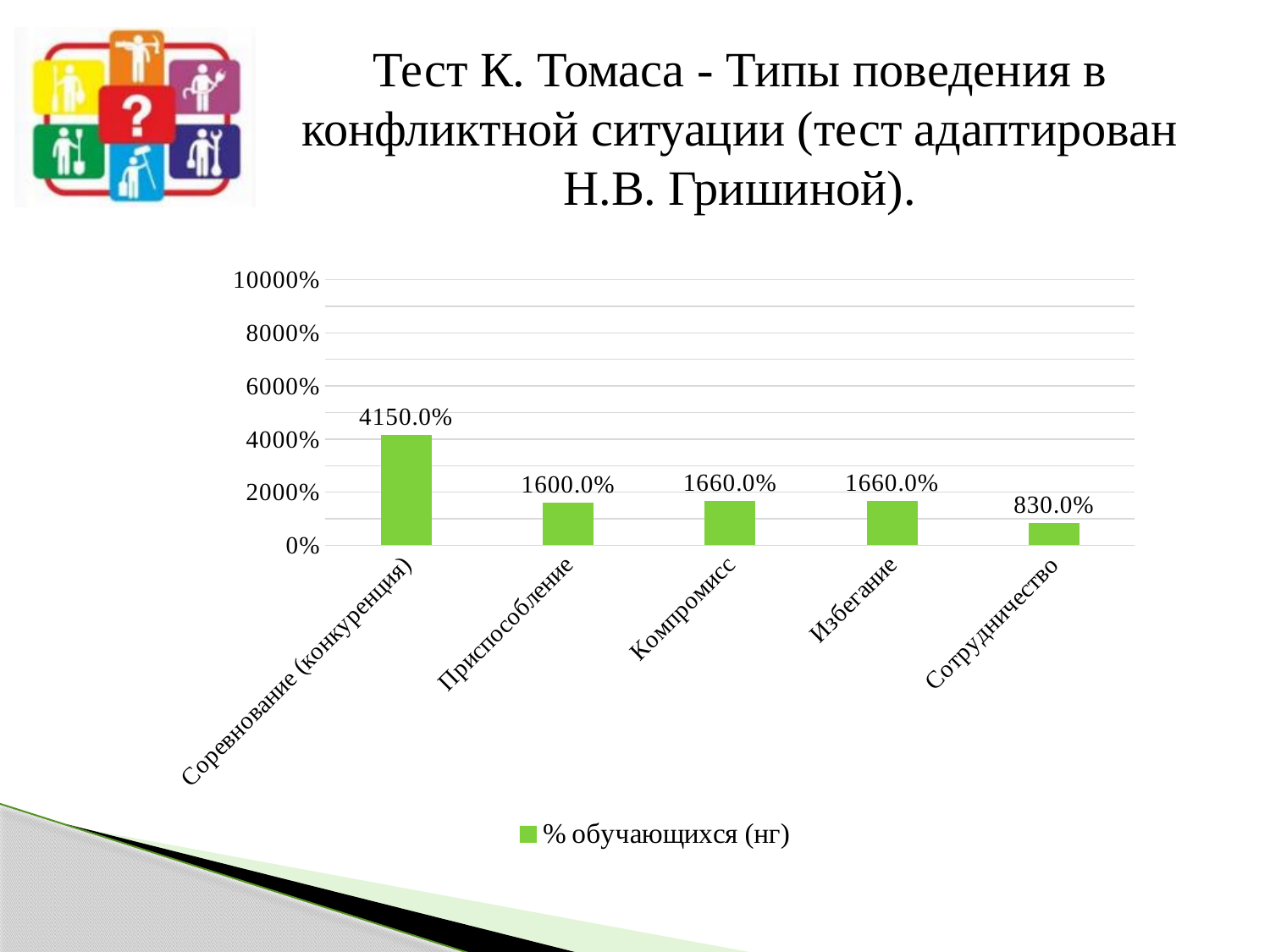
What kind of chart is shown on the slide? bar chart What is the value for Соревнование (конкуренция)? 4150.0% What series name does the legend show? % обучающихся (нг) What is the value for Сотрудничество? 830.0% How many categories are shown on the x axis? 5 What is the difference between the values for Соревнование (конкуренция) and Сотрудничество? 3320.0% Is the value for Соревнование (конкуренция) greater or less than 4000%? greater Which is larger, the value for Приспособление or the value for Сотрудничество? Приспособление Which category has the lowest value? Сотрудничество Which category has the highest value? Соревнование (конкуренция) What is the value for Приспособление? 1600.0% What is the difference between the values for Компромисс and Приспособление? 60.0%